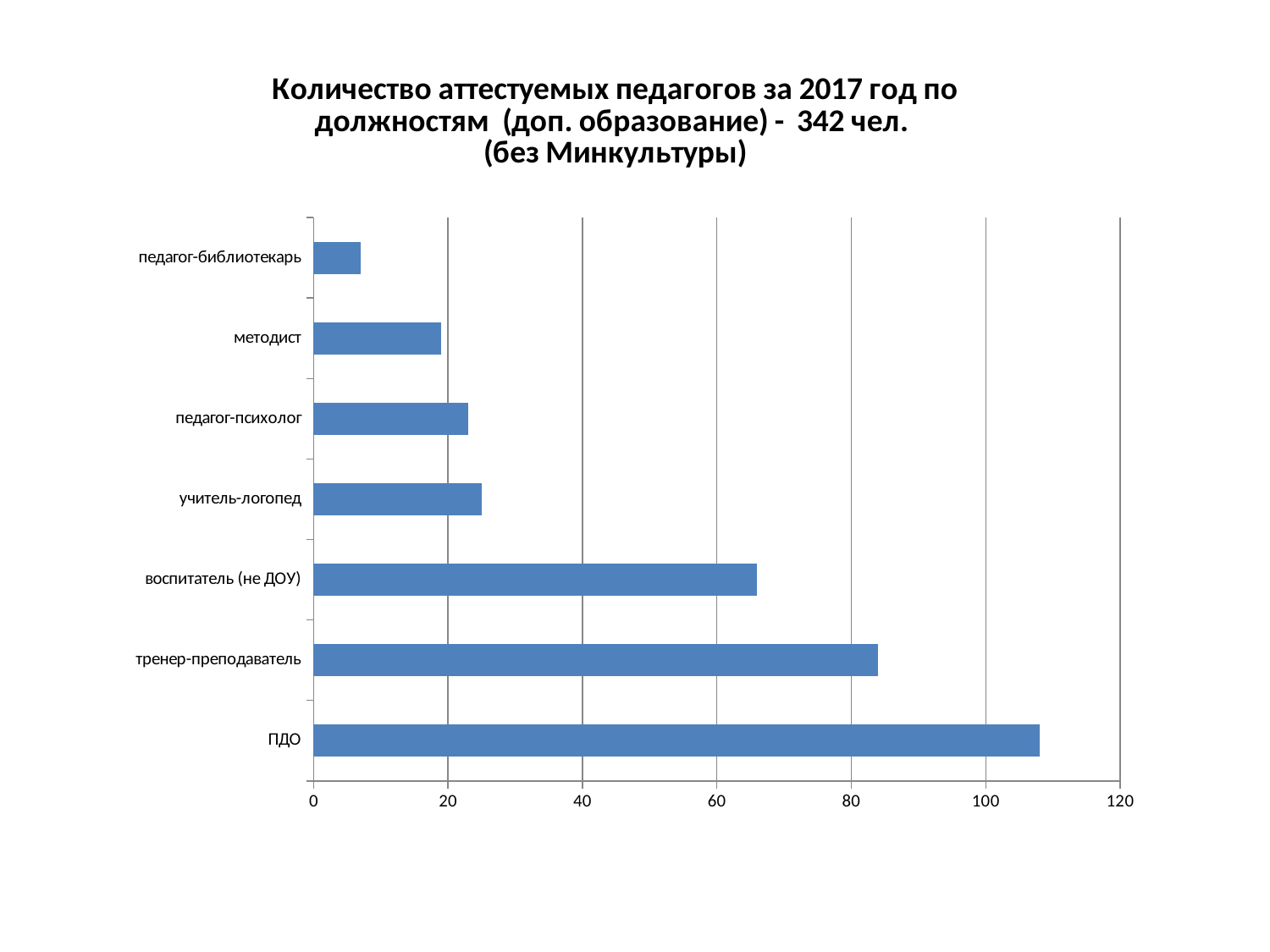
Is the value for тренер-преподаватель greater or less than 80? greater Is the value for воспитатель (не ДОУ) greater or less than 60? greater Which category has the highest value? ПДО Which category has the lowest value? педагог-библиотекарь How many job categories are shown in the chart? 7 Which is larger, the value for методист or the value for педагог-библиотекарь? методист According to the chart title, how many teachers in total were certified in 2017? 342 чел. Which is larger, the value for ПДО or the value for тренер-преподаватель? ПДО Is the value for педагог-библиотекарь greater or less than 20? less What kind of chart is shown on the slide? bar chart